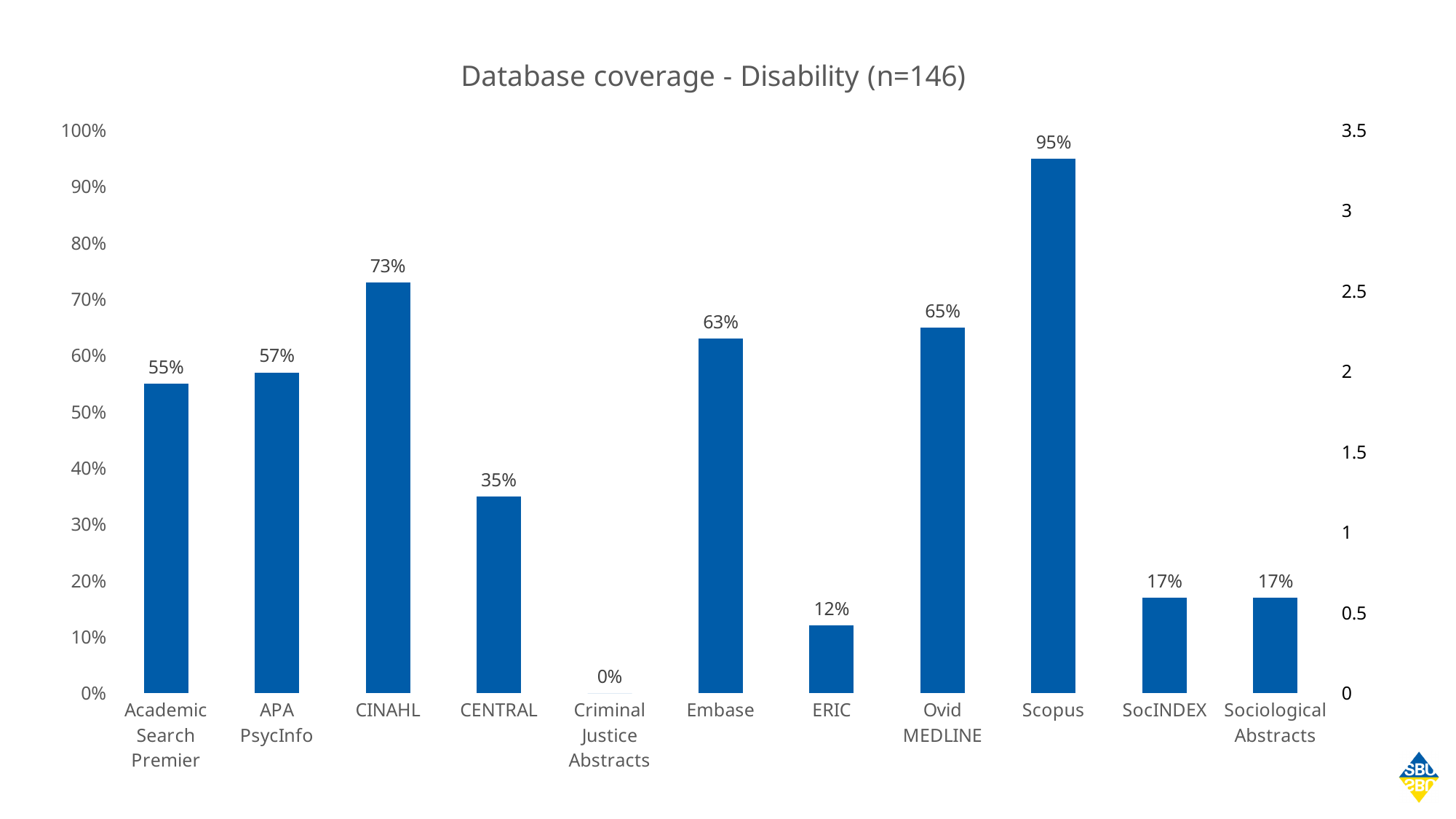
What kind of chart is shown on the slide? Bar chart Which has higher coverage, APA PsycInfo or Academic Search Premier? APA PsycInfo Which has higher coverage, ERIC or SocINDEX? SocINDEX Which database has the highest coverage? Scopus Which database has the lowest coverage? Criminal Justice Abstracts What is the database coverage value for Criminal Justice Abstracts? 0% What is the database coverage value for CINAHL? 73% What is the difference between the coverage of Embase and CENTRAL? 28% What is the database coverage value for Ovid MEDLINE? 65% What is the title of the chart? Database coverage - Disability (n=146) How many databases are shown on the x axis? 11 What is the difference between the coverage of Scopus and CINAHL? 22%